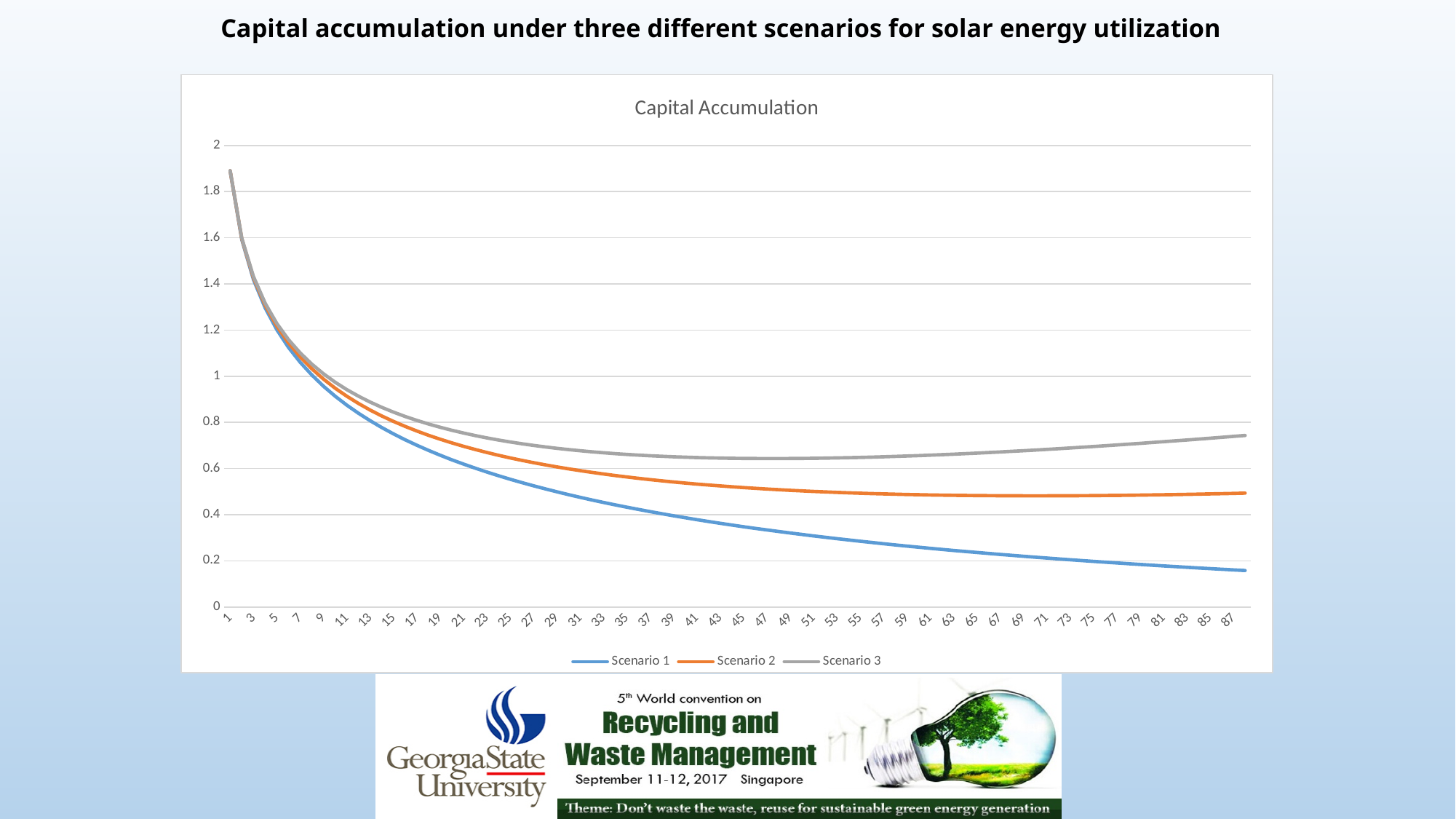
Does the Scenario 1 line rise or fall as the x axis increases? fall Which scenario has the highest value at the right end of the x axis (point 87)? Scenario 3 At point 87, is the value for Scenario 1 greater or less than 0.2? less At point 87, is the value for Scenario 3 greater or less than 0.6? greater What is the title shown inside the chart area? Capital Accumulation Which scenario has the lowest value at the right end of the x axis (point 87)? Scenario 1 At point 47, which is larger: the value for Scenario 2 or the value for Scenario 1? Scenario 2 What kind of chart is shown on the slide? line chart At point 87, is the value for Scenario 2 greater or less than 0.6? less Which colour is used for the Scenario 2 line? orange How many series does the legend list? 3